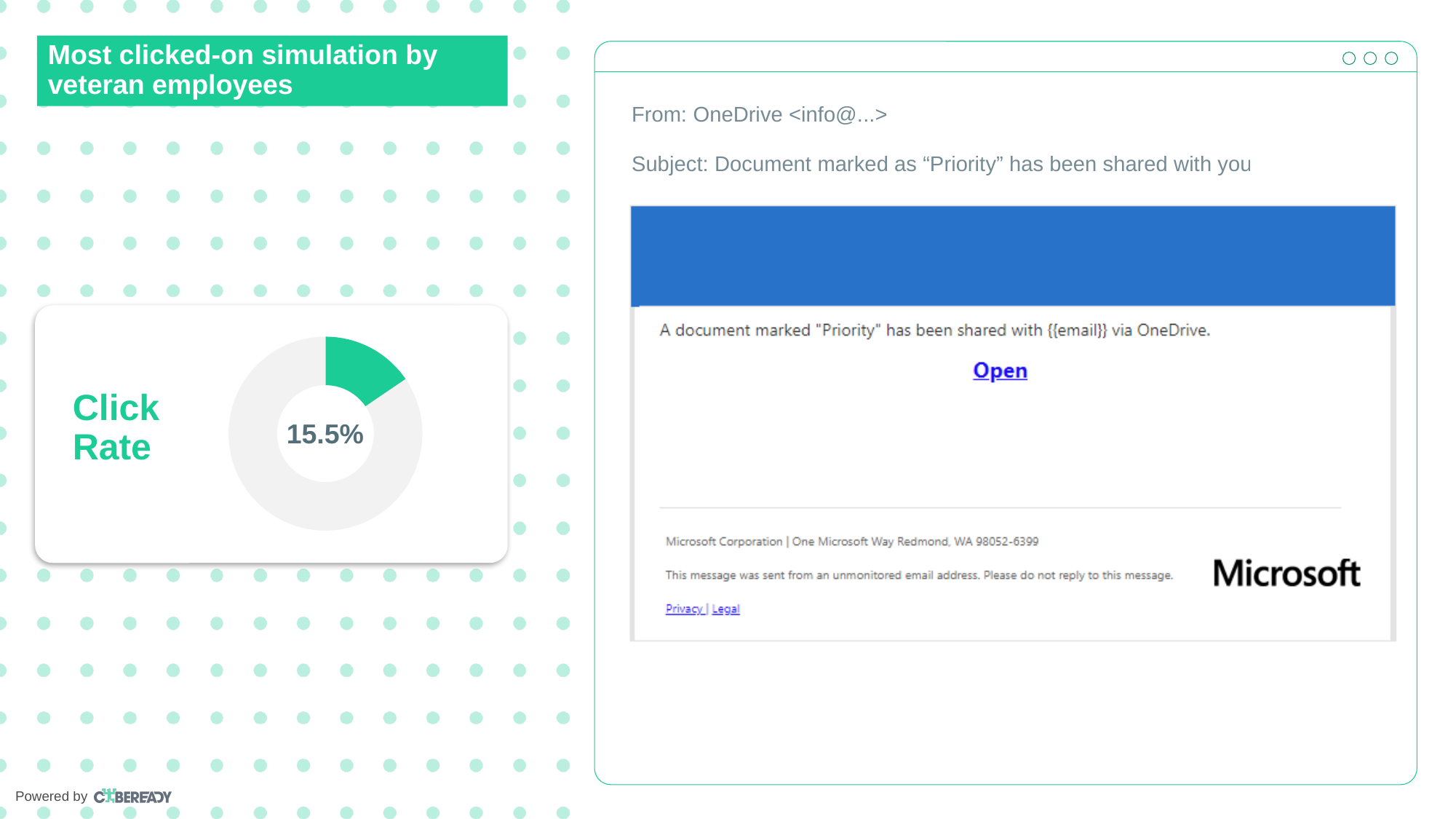
What is the title of the slide containing the click rate chart? Most clicked-on simulation by veteran employees What metric is labelled next to the donut chart? Click Rate What kind of chart is used to display the click rate? Donut (pie) chart How many data values are printed on the donut chart? 1 What share of the donut chart does the green segment represent? 15.5% Which segment of the donut chart is larger, the green one or the grey one? The grey one What click rate does the donut chart show? 15.5%